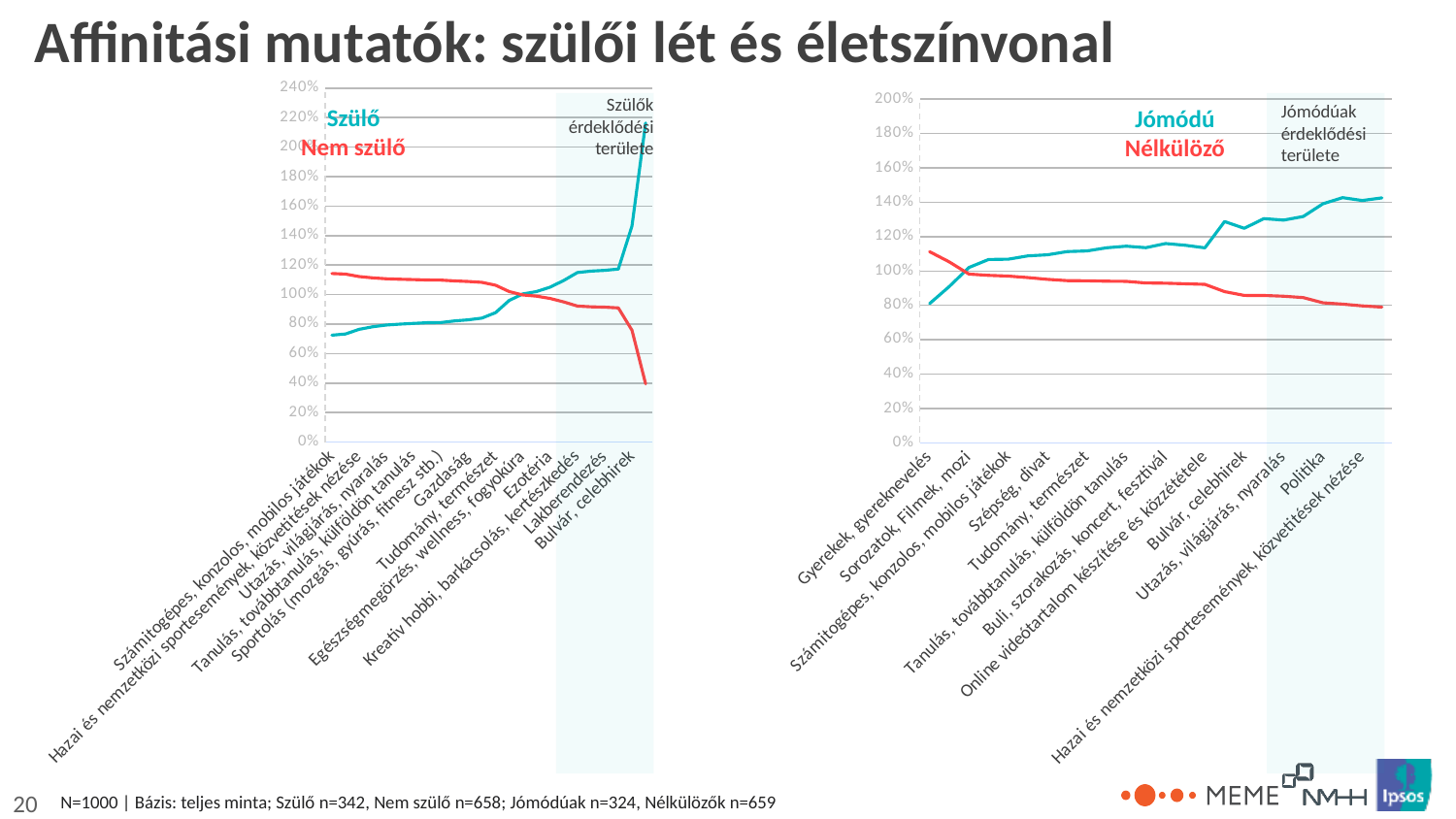
In the right chart, is the Jómódú value for Politika greater or less than 120%? greater How many series does the legend of the right chart list? 2 In the right chart, is the Nélkülöző value for Politika greater or less than 100%? less What kind of chart is the left chart on the slide? Line chart In the right chart, which series has the larger value for Gyerekek, gyereknevelés, Jómódú or Nélkülöző? Nélkülöző In the left chart, which series has the larger value for Bulvár, celebhírek, Szülő or Nem szülő? Szülő In the left chart, is the Szülő value for Bulvár, celebhírek greater or less than 200%? less What label is written in the shaded area on the right side of the right chart? Jómódúak érdeklődési területe In the left chart, does the Nem szülő line rise or fall from left to right along the x axis? Fall